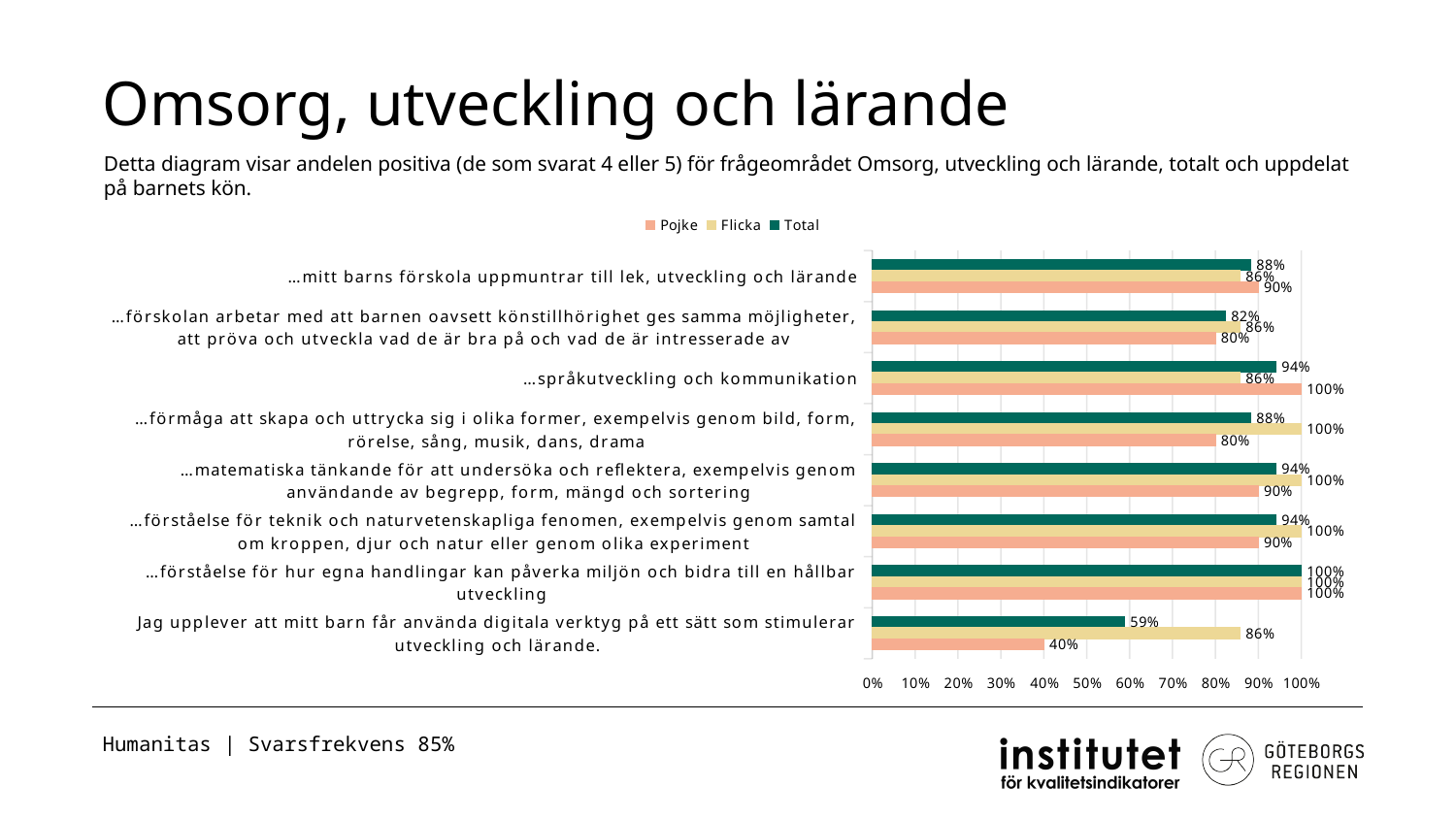
Which category has the lowest Total value? Jag upplever att mitt barn får använda digitala verktyg på ett sätt som stimulerar utveckling och lärande. Is the Total value for "Jag upplever att mitt barn får använda digitala verktyg på ett sätt som stimulerar utveckling och lärande." greater or less than 70%? less What is the Total value for "…språkutveckling och kommunikation"? 94% What is the difference between the Flicka and Pojke values for "Jag upplever att mitt barn får använda digitala verktyg på ett sätt som stimulerar utveckling och lärande."? 46 percentage points What kind of chart is shown on the slide? Bar chart For "…mitt barns förskola uppmuntrar till lek, utveckling och lärande", which is larger, the Pojke value or the Flicka value? Pojke How many series does the legend list? 3 Which category has the highest Total value? …förståelse för hur egna handlingar kan påverka miljön och bidra till en hållbar utveckling How many categories are shown in the chart? 8 What is the Pojke value for "Jag upplever att mitt barn får använda digitala verktyg på ett sätt som stimulerar utveckling och lärande."? 40% What is the Flicka value for "…förmåga att skapa och uttrycka sig i olika former, exempelvis genom bild, form, rörelse, sång, musik, dans, drama"? 100% What are the three series listed in the legend? Pojke, Flicka, Total